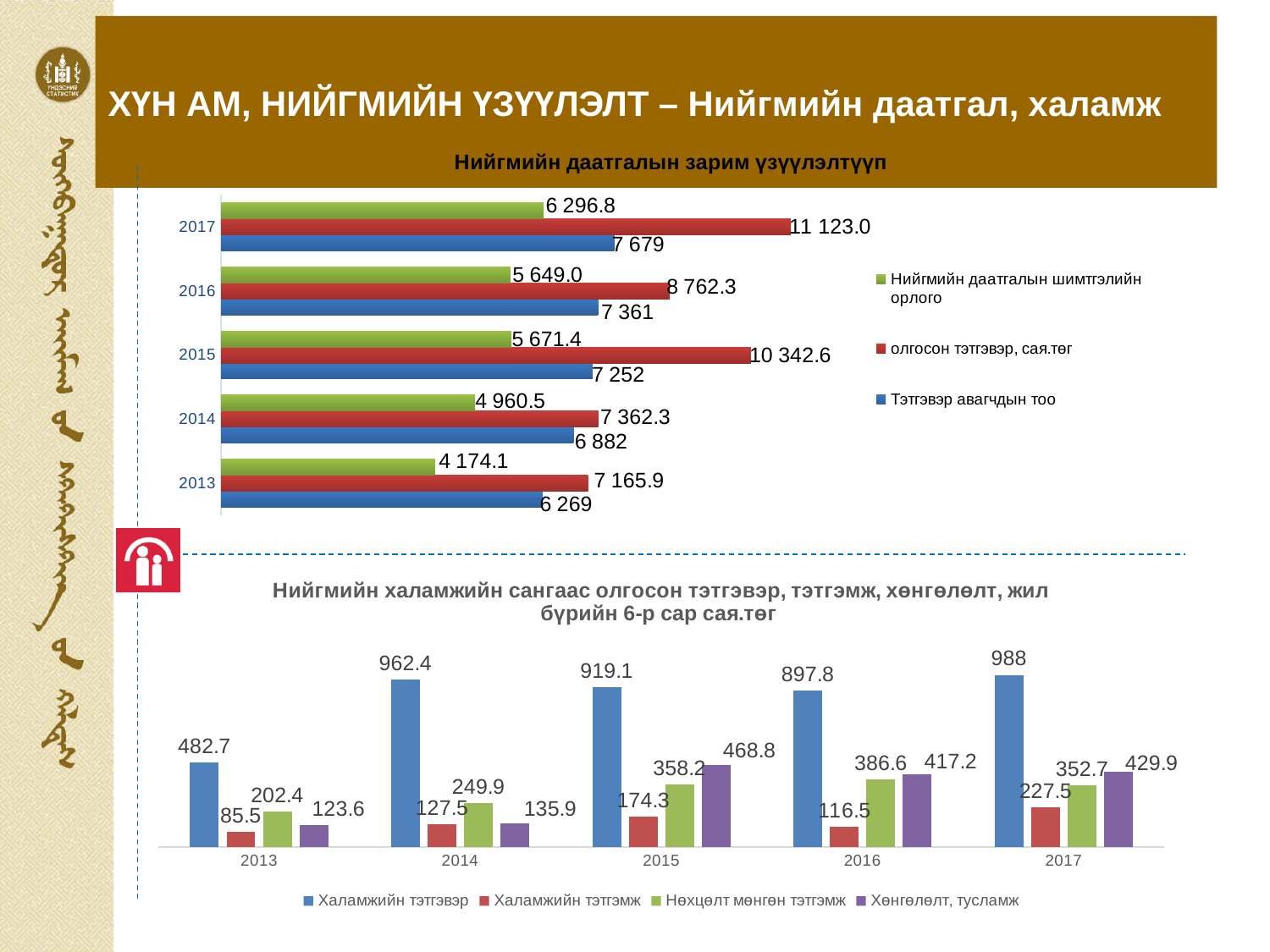
In the top chart (Нийгмийн даатгалын зарим үзүүлэлтүүд), which year has the highest value for 'Нийгмийн даатгалын шимтгэлийн орлого'? 2017 In the bottom chart (Нийгмийн халамжийн сангаас олгосон тэтгэвэр, тэтгэмж, хөнгөлөлт), what is the value of 'Халамжийн тэтгэвэр' for 2017? 988 What kind of chart is the bottom chart (Нийгмийн халамжийн сангаас олгосон тэтгэвэр, тэтгэмж, хөнгөлөлт)? bar chart In the bottom chart (Нийгмийн халамжийн сангаас олгосон тэтгэвэр, тэтгэмж, хөнгөлөлт), which year has the lowest value for 'Халамжийн тэтгэмж'? 2013 In the top chart (Нийгмийн даатгалын зарим үзүүлэлтүүд), does 'Тэтгэвэр авагчдын тоо' rise or fall from 2013 to 2017? rise In the top chart (Нийгмийн даатгалын зарим үзүүлэлтүүд), what is the value of 'олгосон тэтгэвэр, сая.төг' for 2017? 11 123.0 In the bottom chart (Нийгмийн халамжийн сангаас олгосон тэтгэвэр, тэтгэмж, хөнгөлөлт), how many years are shown on the x axis? 5 In the top chart (Нийгмийн даатгалын зарим үзүүлэлтүүд), what is the difference between 'Тэтгэвэр авагчдын тоо' in 2017 and in 2016? 318 In the top chart (Нийгмийн даатгалын зарим үзүүлэлтүүд), how many series does the legend list? 3 In the top chart (Нийгмийн даатгалын зарим үзүүлэлтүүд), what is the value of 'Тэтгэвэр авагчдын тоо' for 2013? 6 269 In the top chart (Нийгмийн даатгалын зарим үзүүлэлтүүд), which year has the lowest value for 'олгосон тэтгэвэр, сая.төг'? 2013 In the bottom chart (Нийгмийн халамжийн сангаас олгосон тэтгэвэр, тэтгэмж, хөнгөлөлт), which is larger in 2015: 'Нөхцөлт мөнгөн тэтгэмж' or 'Хөнгөлөлт, тусламж'? Хөнгөлөлт, тусламж